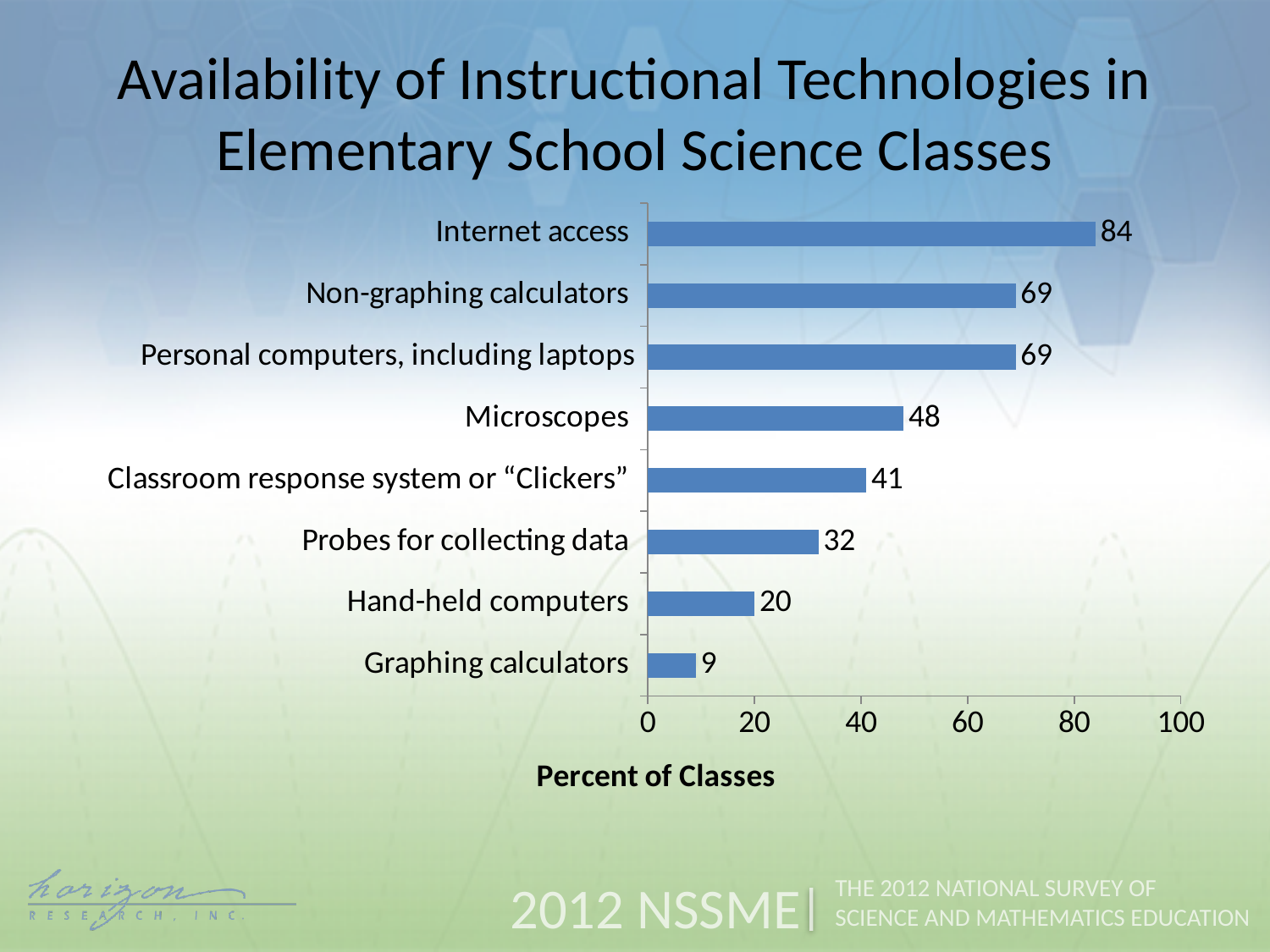
What is the label of the horizontal axis? Percent of Classes Which is larger, the value for Classroom response system or "Clickers" or the value for Probes for collecting data? Classroom response system or "Clickers" Is the value for Non-graphing calculators greater or less than 60? greater What percent of classes have Internet access available? 84 What is the difference between the values for Internet access and Graphing calculators? 75 Which technology has the highest percent of classes? Internet access What is the value for Microscopes? 48 How many technology categories are shown in the chart? 8 What is the value for Probes for collecting data? 32 What kind of chart is shown on the slide? bar chart Which technology has the lowest percent of classes? Graphing calculators What is the difference between the values for Microscopes and Hand-held computers? 28